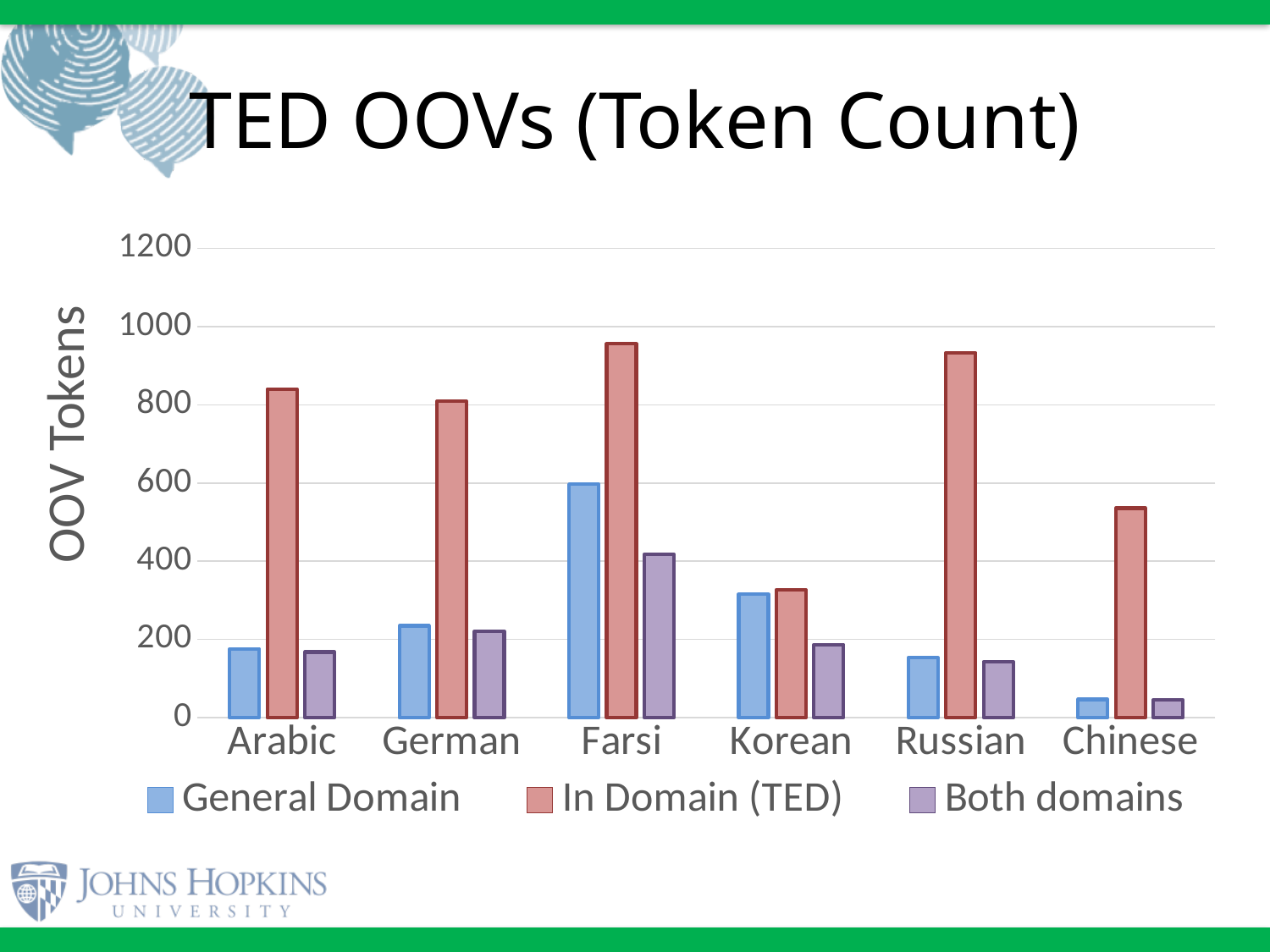
Which language has the lowest General Domain value? Chinese Which is larger for Farsi: the General Domain value or the Both domains value? General Domain Which language has the highest General Domain value? Farsi Which language has the lowest In Domain (TED) value? Korean What is the label on the y axis? OOV Tokens How many series does the legend list? 3 What type of chart is shown on the slide? bar chart Is the General Domain value for Farsi greater or less than 400? greater Is the In Domain (TED) value for Chinese greater or less than 600? less How many languages are shown on the x axis? 6 Which language has the highest Both domains value? Farsi What is the title of the chart? TED OOVs (Token Count)